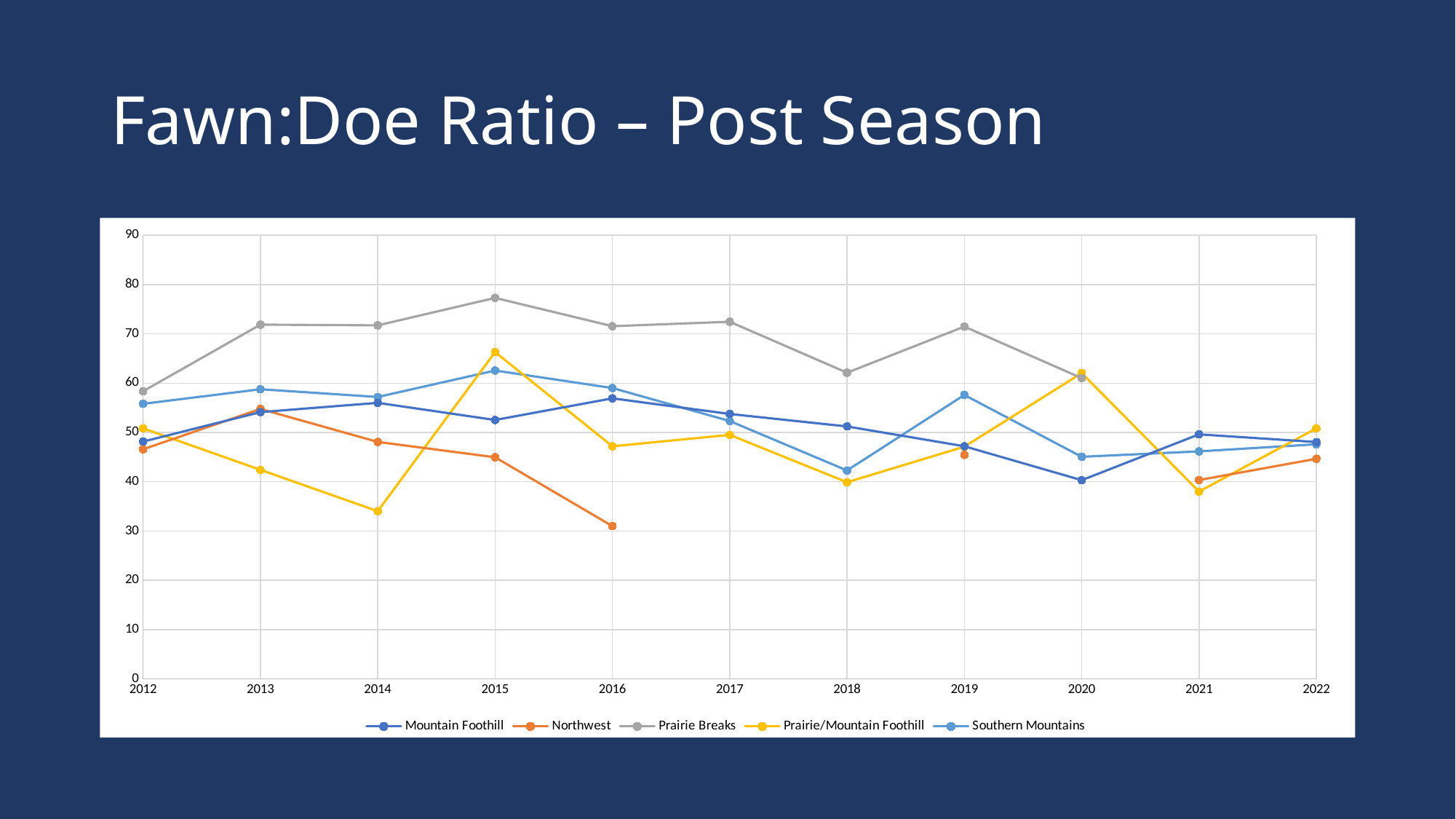
How many series does the legend list? 5 Which series has the highest value in 2015? Prairie Breaks In 2013, which is larger: Prairie Breaks or Mountain Foothill? Prairie Breaks What is the title of the slide? Fawn:Doe Ratio – Post Season Is the value for Prairie/Mountain Foothill in 2014 greater or less than 40? less How many years are shown on the x axis? 11 In which year does the Prairie Breaks series reach its highest value? 2015 Is the value for Prairie Breaks in 2015 greater or less than 70? greater Which series has the lowest value in 2016? Northwest What kind of chart is shown on the slide? Line chart Is the value for Northwest in 2016 greater or less than 40? less Does the Mountain Foothill series rise or fall from 2016 to 2020? fall